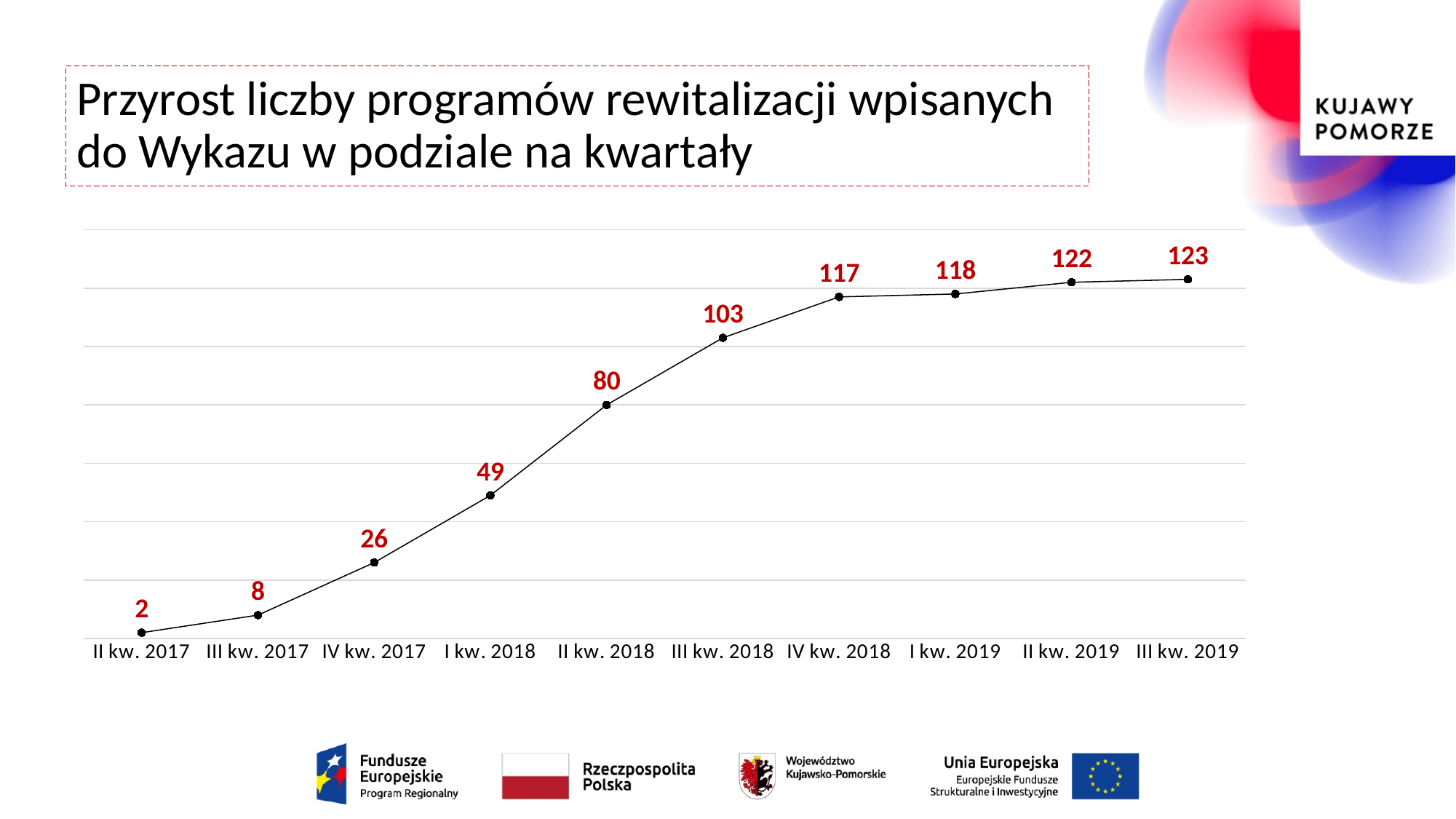
What is the value for IV kw. 2017? 26 What kind of chart is shown on the slide? line chart Which quarter has the lowest value? II kw. 2017 Do the values rise or fall from II kw. 2017 to III kw. 2019? rise What is the difference between the values for III kw. 2019 and II kw. 2017? 121 Which is larger, the value for I kw. 2018 or the value for IV kw. 2018? IV kw. 2018 Which quarter has the highest value? III kw. 2019 What is the value for II kw. 2018? 80 What is the value for I kw. 2019? 118 How many quarters are plotted on the chart? 10 What is the difference between the values for III kw. 2018 and II kw. 2018? 23 What is the title of the slide? Przyrost liczby programów rewitalizacji wpisanych do Wykazu w podziale na kwartały